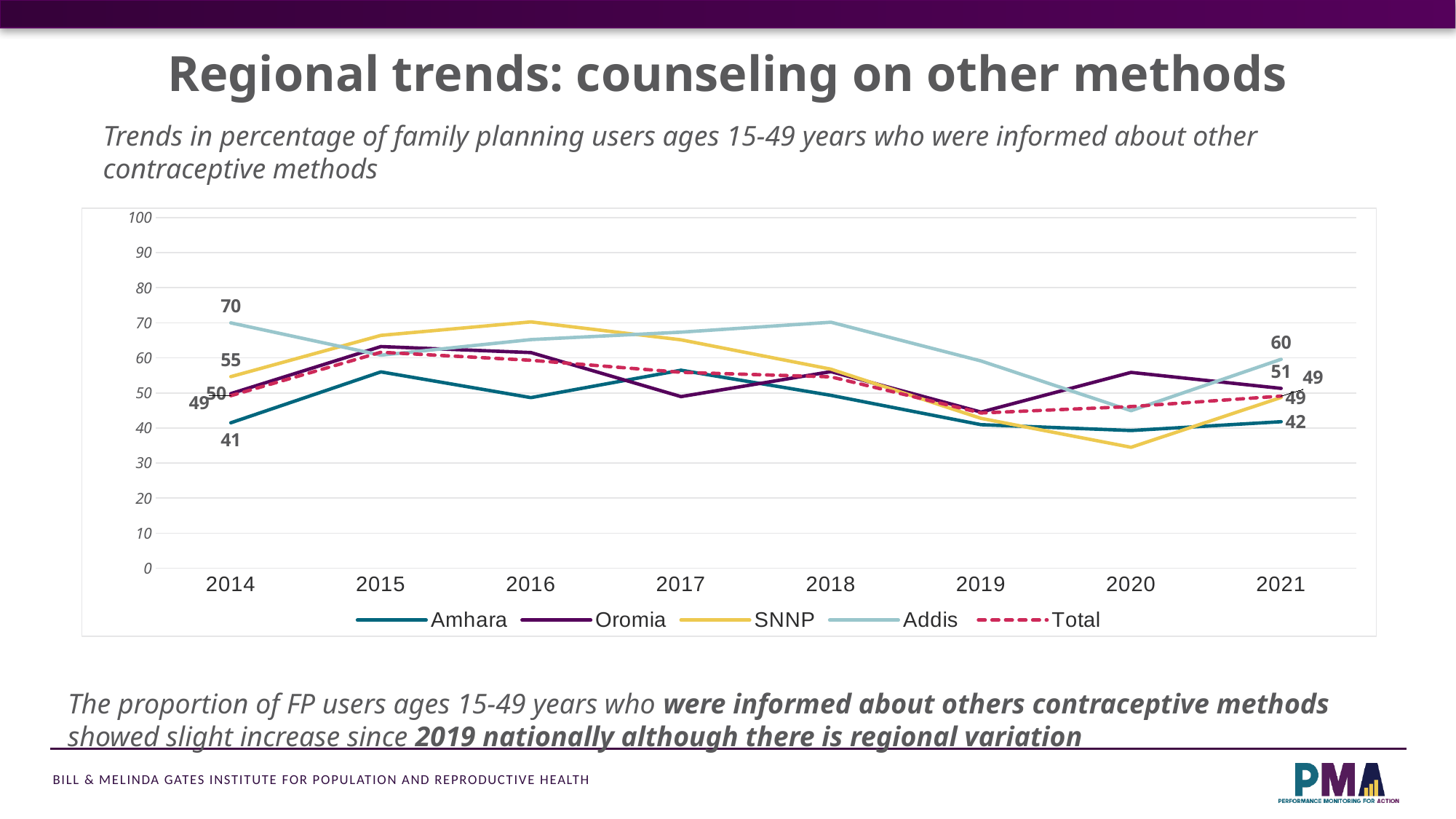
Which region had the highest value in 2014? Addis By how much did the value for Addis fall from 2014 to 2021? 10 Is the value for SNNP in 2020 greater or less than 40? less What is the value for Amhara in 2014? 41 What kind of chart is shown on the slide? line chart What is the value for Addis in 2014? 70 What is the value for Amhara in 2021? 42 What is the value for SNNP in 2014? 55 How many years are shown on the x axis? 8 What is the value for Addis in 2021? 60 Which series is drawn as a dashed line? Total How many series does the legend list? 5